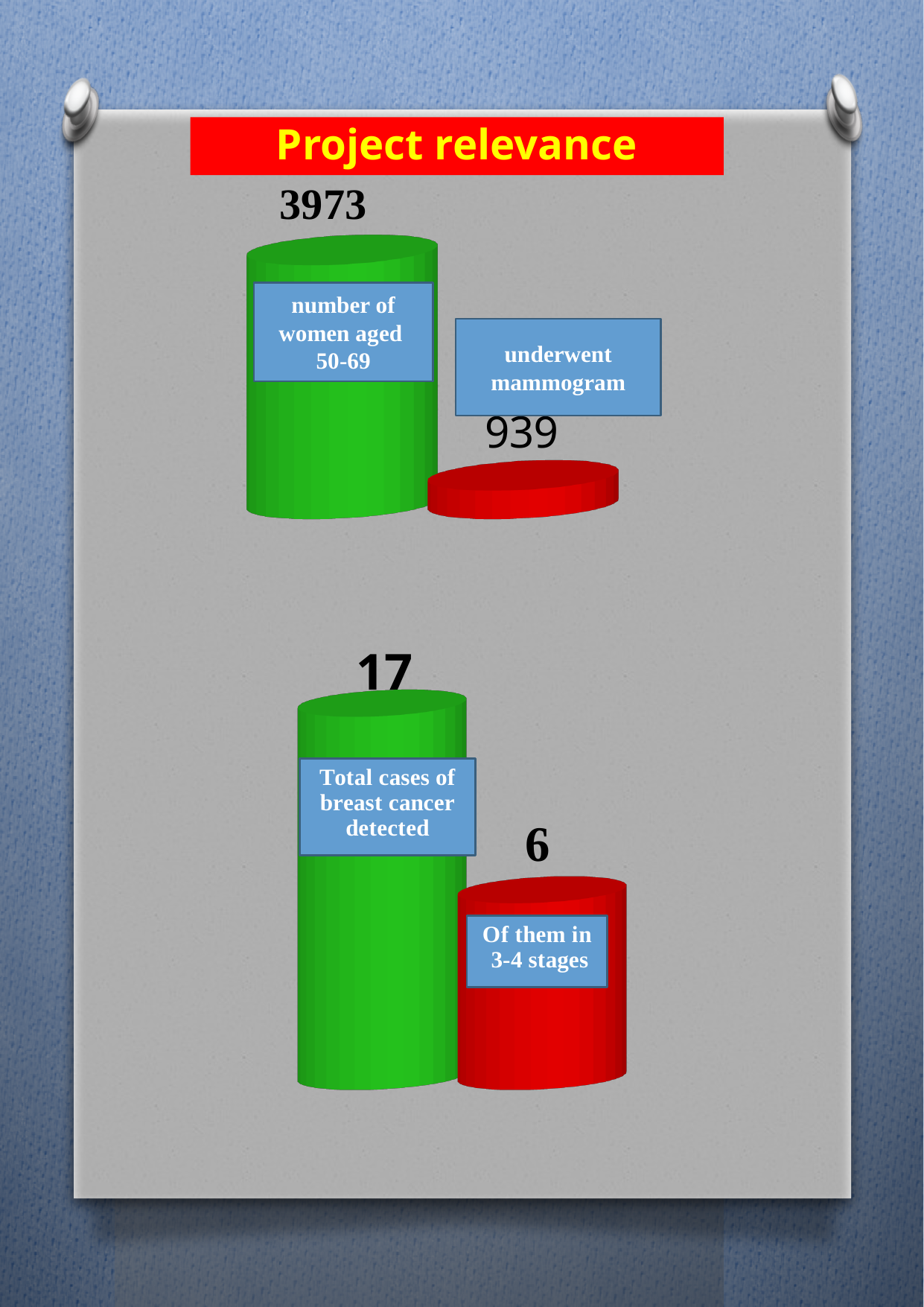
What is the title shown at the top of the slide? Project relevance In the top chart, what is the value for number of women aged 50-69? 3973 In the bottom chart, is the value for Total cases of breast cancer detected larger or smaller than the value for Of them in 3-4 stages? larger In the top chart, how many bars are shown? 2 In the bottom chart, which category has the lower value? Of them in 3-4 stages In the bottom chart, what is the value for Total cases of breast cancer detected? 17 In the bottom chart, what is the difference between Total cases of breast cancer detected and Of them in 3-4 stages? 11 In the top chart, what is the difference between the number of women aged 50-69 and those who underwent mammogram? 3034 In the top chart, what is the value for underwent mammogram? 939 In the bottom chart, what is the value for Of them in 3-4 stages? 6 In the top chart, which category has the higher value? number of women aged 50-69 What kind of chart is the bottom chart? bar chart